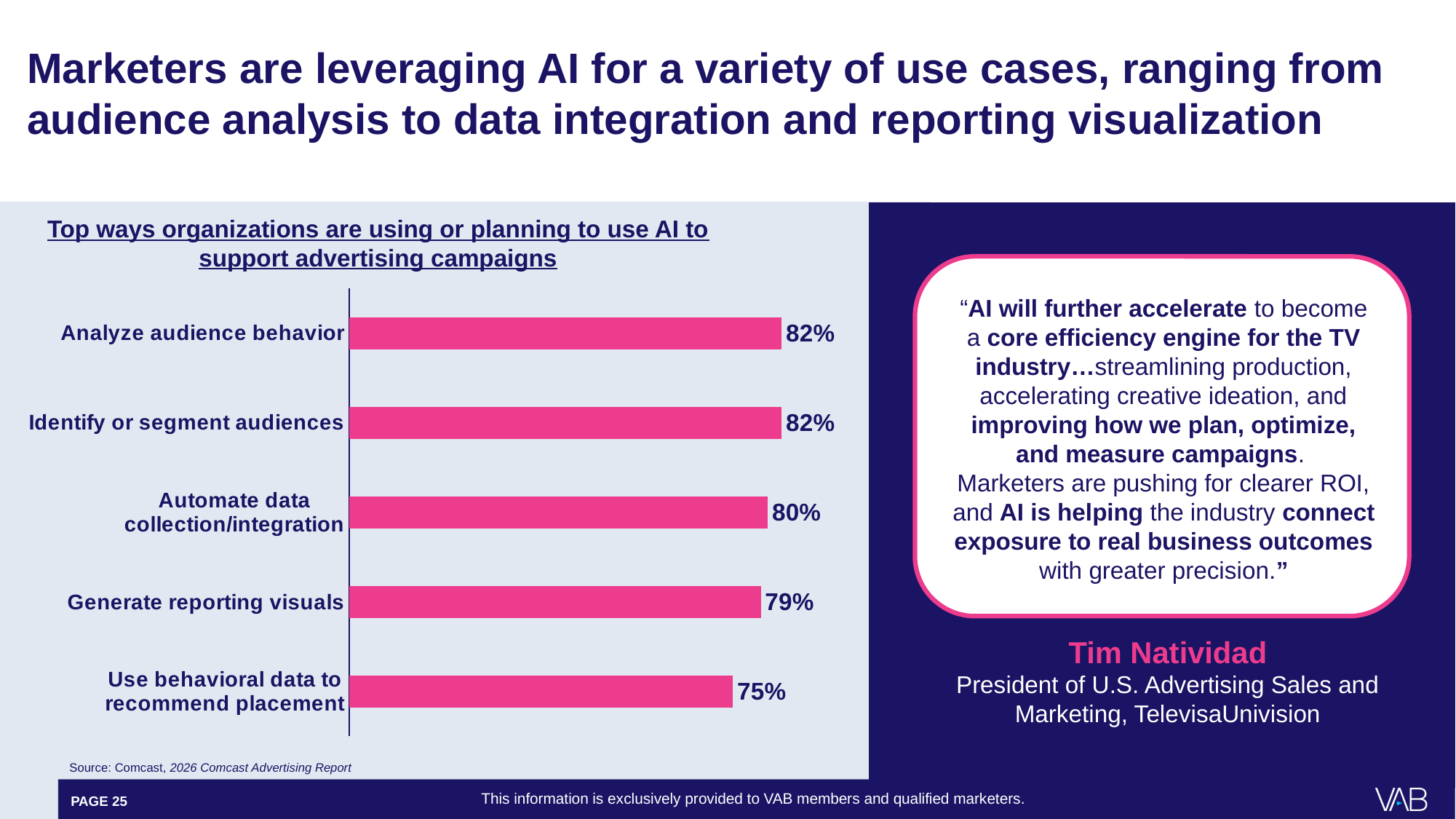
How many categories are shown in the chart? 5 What percentage of organizations are using or planning to use AI to analyze audience behavior? 82% What is the value shown for 'Automate data collection/integration'? 80% What kind of chart is shown on the slide? Bar chart What is the value shown for 'Use behavioral data to recommend placement'? 75% What is the title of the chart? Top ways organizations are using or planning to use AI to support advertising campaigns What is the difference between the values for 'Automate data collection/integration' and 'Generate reporting visuals'? 1% What is the source cited for the chart? Comcast, 2026 Comcast Advertising Report What is the difference between the values for 'Identify or segment audiences' and 'Use behavioral data to recommend placement'? 7% Which is larger: the value for 'Analyze audience behavior' or the value for 'Generate reporting visuals'? Analyze audience behavior What is the value shown for 'Generate reporting visuals'? 79% Which category has the lowest value in the chart? Use behavioral data to recommend placement